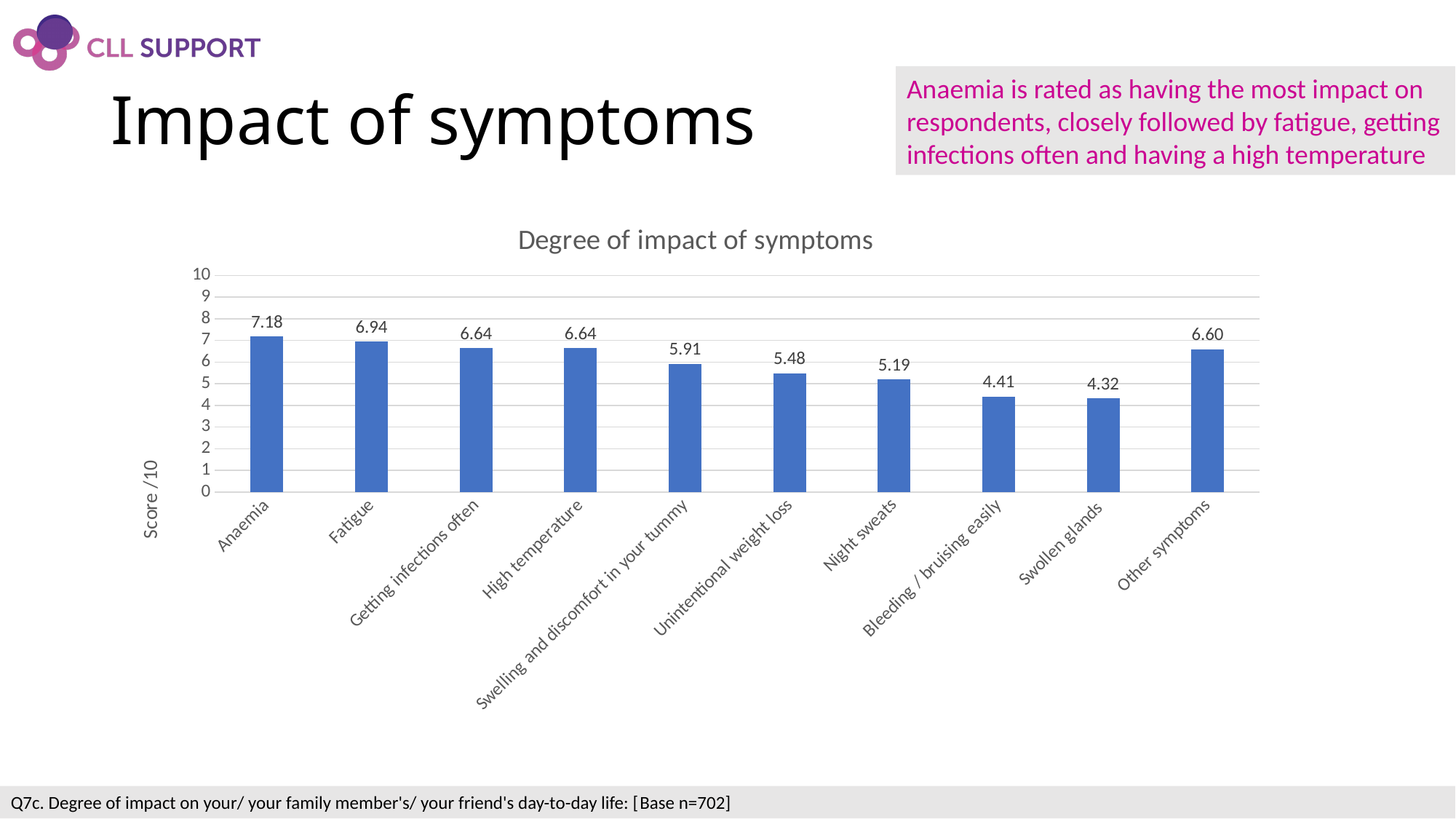
What is the score for Other symptoms? 6.60 Is the score for Bleeding / bruising easily greater or less than 5? less What is the difference between the scores for Anaemia and Fatigue? 0.24 How many symptom categories are shown on the chart? 10 What is the score for Night sweats? 5.19 Which symptom has the lowest score? Swollen glands What is the title of the chart? Degree of impact of symptoms What is the score for Anaemia? 7.18 Which has a higher score, Fatigue or Night sweats? Fatigue What is the difference between the scores for Unintentional weight loss and Swollen glands? 1.16 Which symptom has the highest score? Anaemia What kind of chart is shown on the slide? bar chart